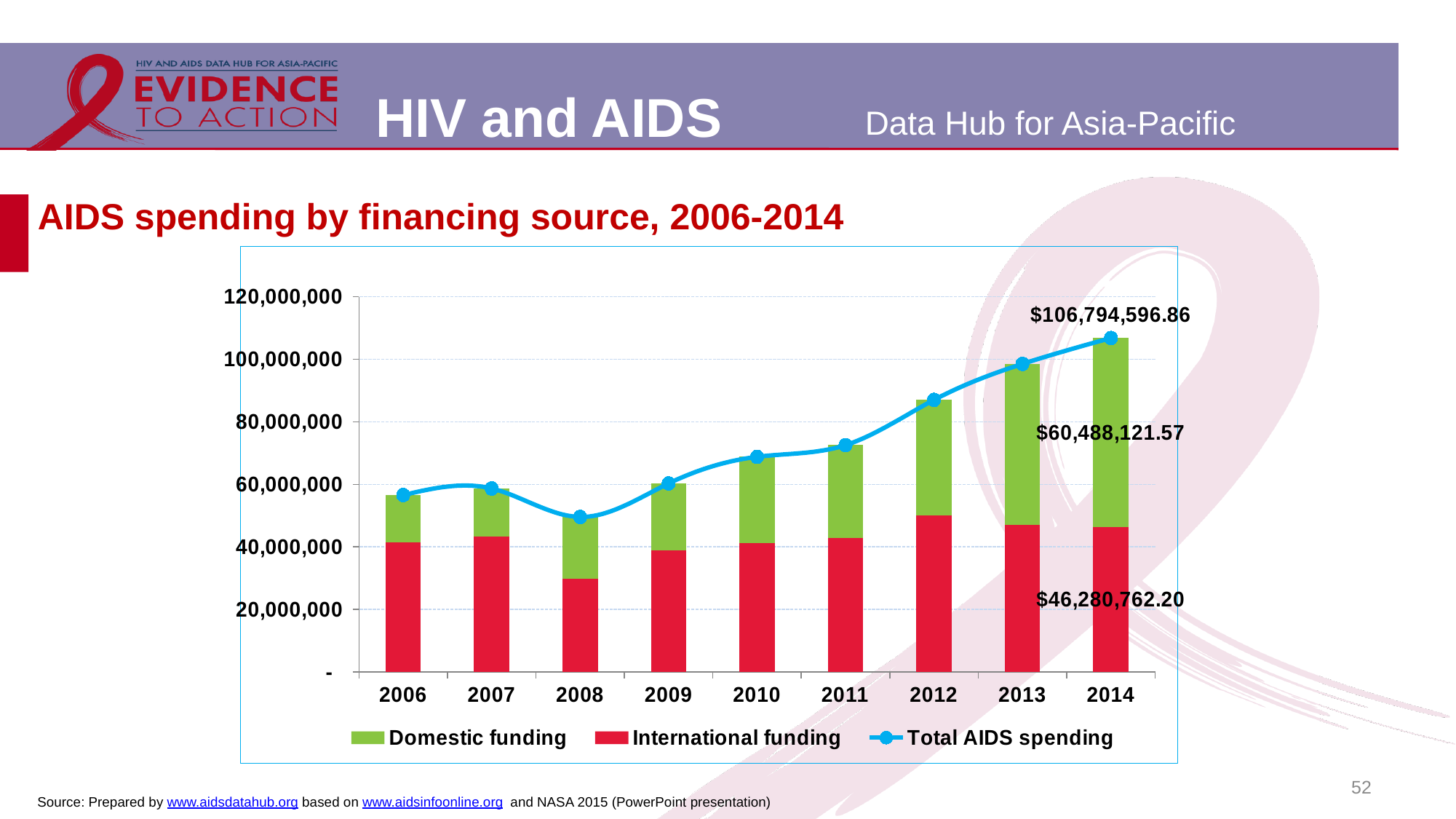
What is the International funding value labelled for 2014? $46,280,762.20 In 2014, which is larger: Domestic funding or International funding? Domestic funding What is the difference between Domestic funding and International funding in 2014? $14,207,359.37 Which year has the lowest Total AIDS spending? 2008 Does Total AIDS spending rise or fall from 2008 to 2014? Rises How many series does the legend list? 3 How many years are shown on the x axis? 9 What is the Domestic funding value labelled for 2014? $60,488,121.57 What is the Total AIDS spending value labelled for 2014? $106,794,596.86 Is the Total AIDS spending for 2008 greater or less than 60,000,000? less Which year has the highest Total AIDS spending? 2014 What kind of chart is shown on the slide? Stacked bar chart with a line